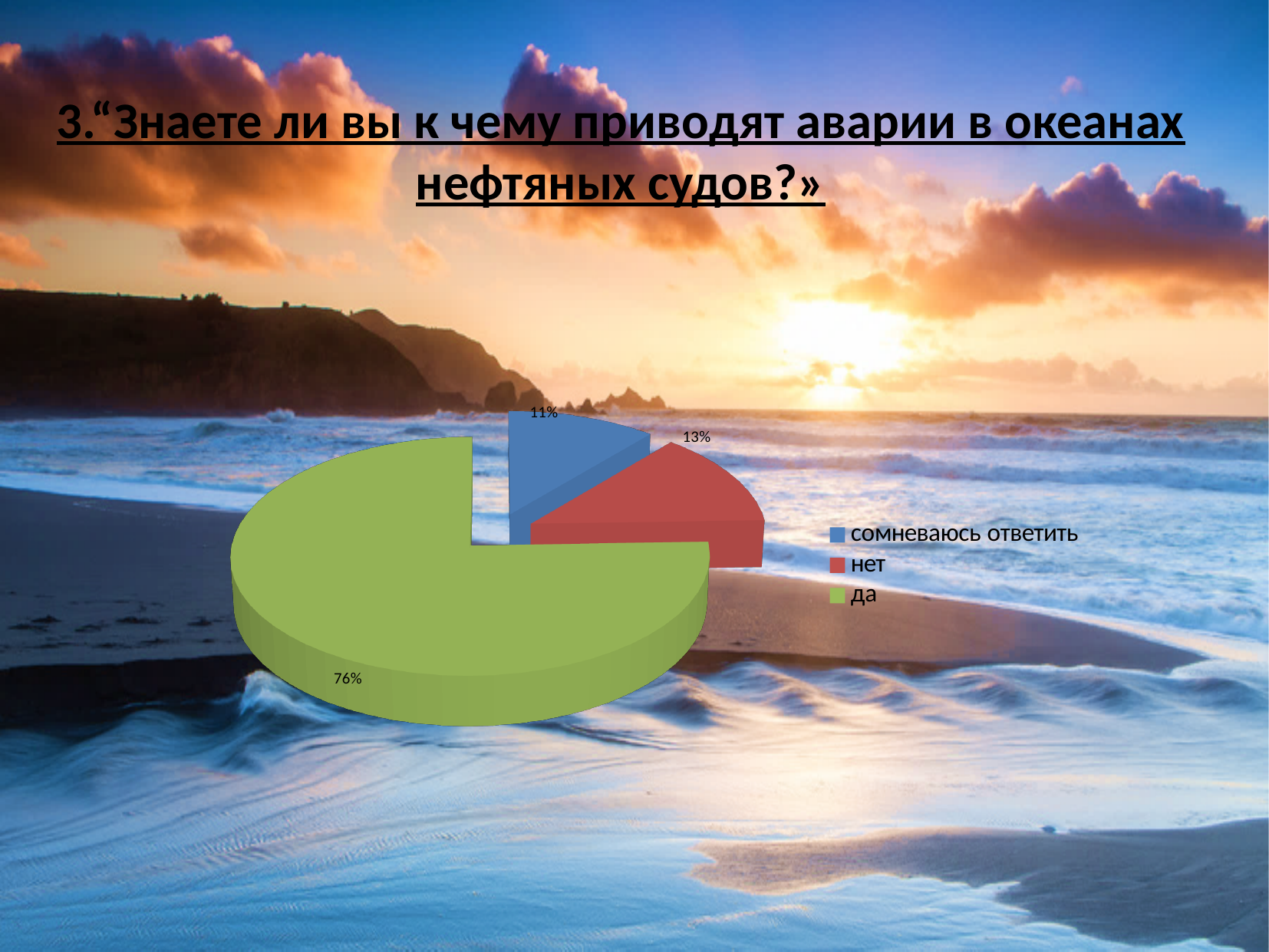
Which is larger, the slice for "да" or the slice for "нет"? да How many categories does the pie chart have? 3 What is the difference in percentage points between "да" and "нет"? 63 What share of the pie does "нет" have? 13% Which category has the smallest slice of the pie? сомневаюсь ответить What kind of chart is shown on the slide? pie chart What share of the pie does "да" have? 76% Which legend entry is shown in red? нет What is the difference in percentage points between "нет" and "сомневаюсь ответить"? 2 What share of the pie does "сомневаюсь ответить" have? 11% What colour is the slice for "да"? green Which category has the largest slice of the pie? да